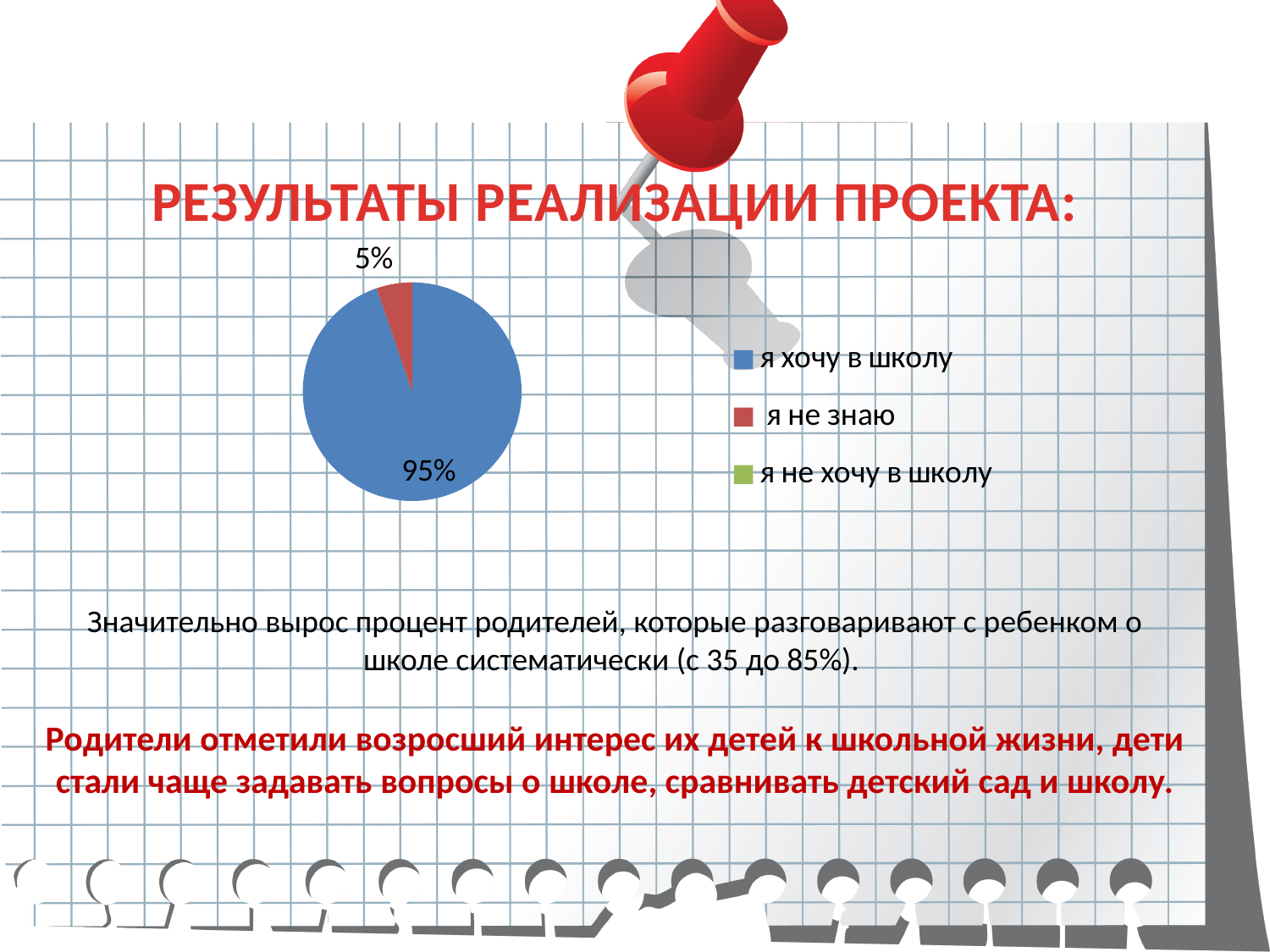
What share of the pie does "я хочу в школу" have? 95% How many slices are visible in the pie? 2 Which legend entry is shown with a green marker? я не хочу в школу What kind of chart is shown on the slide? pie chart Which is larger, the slice for "я хочу в школу" or the slice for "я не знаю"? я хочу в школу What is the difference in percentage points between the "я хочу в школу" slice and the "я не знаю" slice? 90 What is the total of the two labelled slices in the pie? 100% How many entries does the legend list? 3 Which category has the largest slice of the pie? я хочу в школу What share of the pie does "я не знаю" have? 5% Which of the two labelled slices is smaller, "я хочу в школу" or "я не знаю"? я не знаю What colour is the slice for "я не знаю"? red